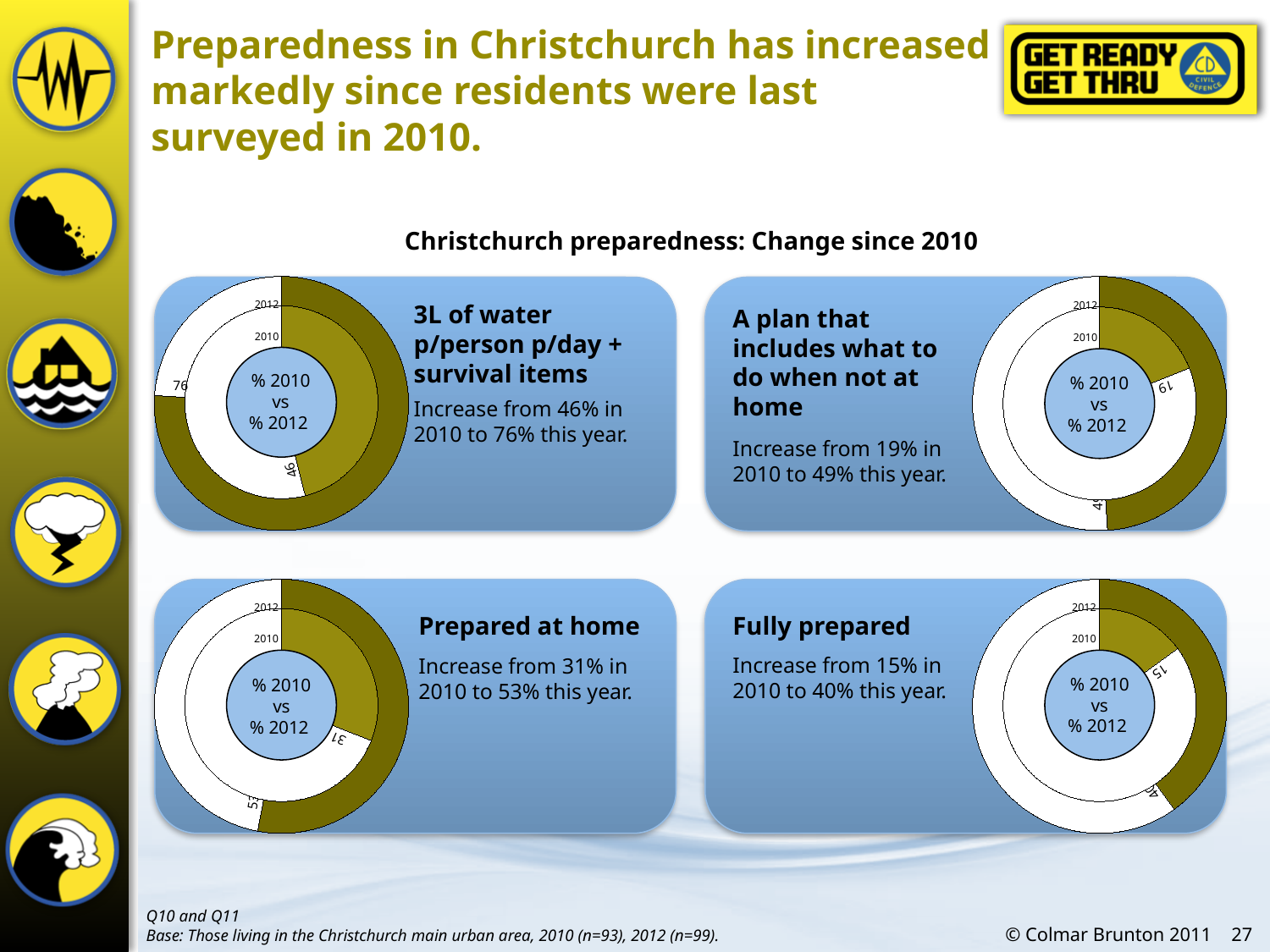
In the 'Fully prepared' chart, which year has the larger value, 2010 or 2012? 2012 In the 'Fully prepared' chart, what is the difference between the 2012 and 2010 values? 25 In the 'Prepared at home' chart, what is the value for 2012? 53 In the 'A plan that includes what to do when not at home' chart, what is the value for 2012? 49 In the 'Fully prepared' chart, what is the value for 2010? 15 What kind of chart is used for the '3L of water p/person p/day + survival items' panel? Doughnut chart How many rings (years) does each doughnut chart on the slide show? 2 In the '3L of water p/person p/day + survival items' chart, what is the value for 2012? 76 In the 'A plan that includes what to do when not at home' chart, what is the value for 2010? 19 In the '3L of water p/person p/day + survival items' chart, by how much did the value increase from 2010 to 2012? 30 In the '3L of water p/person p/day + survival items' chart, what is the value for 2010? 46 In the 'Prepared at home' chart, what is the difference between the 2012 and 2010 values? 22